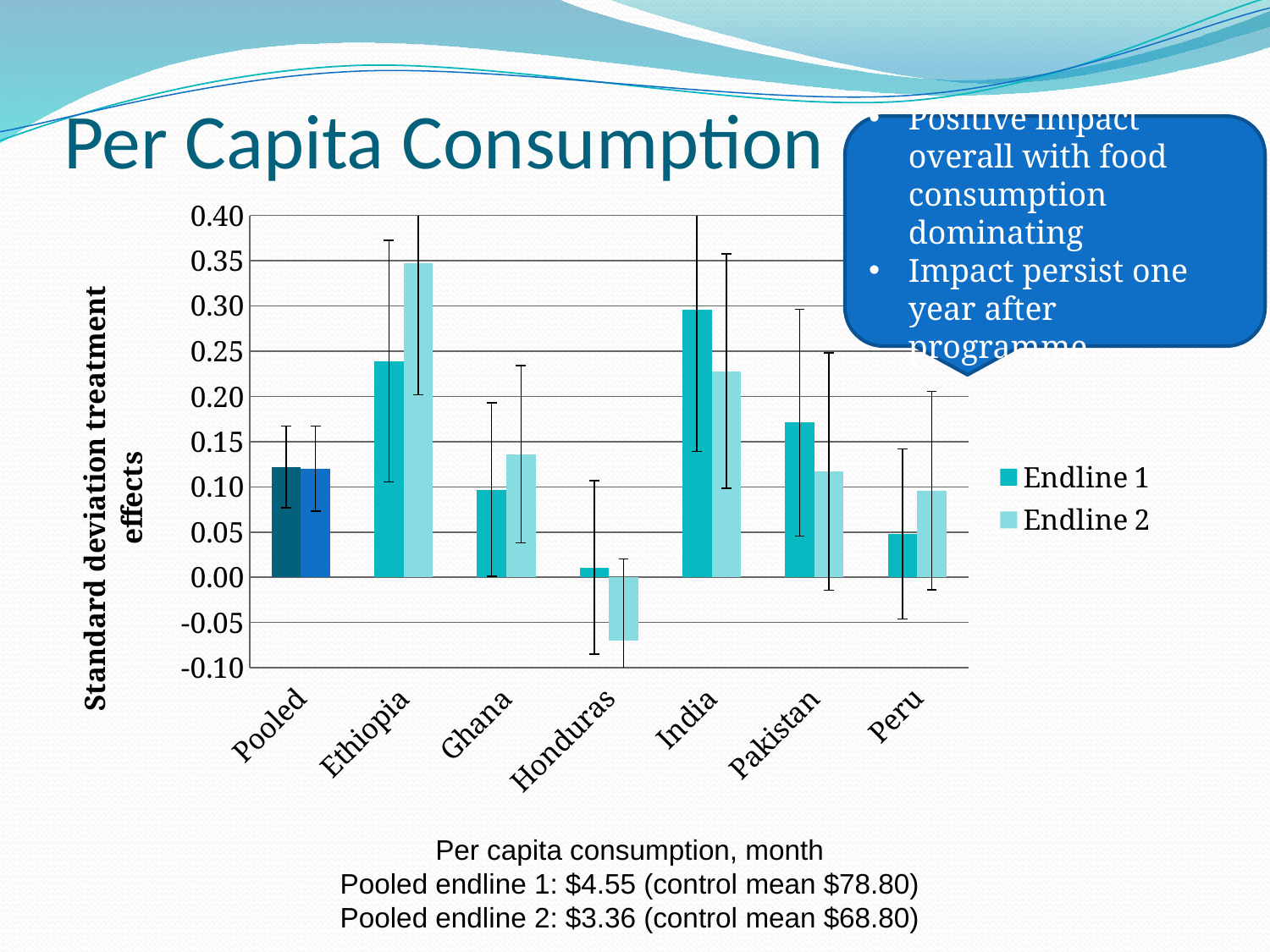
For Ethiopia, which is larger: the Endline 1 value or the Endline 2 value? Endline 2 How many categories are shown on the x axis of the chart? 7 What is the title of the chart's vertical axis? Standard deviation treatment effects Is the Endline 1 value for India greater or less than 0.25? greater Which category has the lowest Endline 2 value? Honduras Is the Endline 1 value for Peru greater or less than 0.10? less What kind of chart is shown on the slide? Bar chart Is the Endline 2 value for Ethiopia greater or less than 0.30? greater Which category has the highest Endline 2 value? Ethiopia How many series does the chart legend list? 2 Which category has the highest Endline 1 value? India